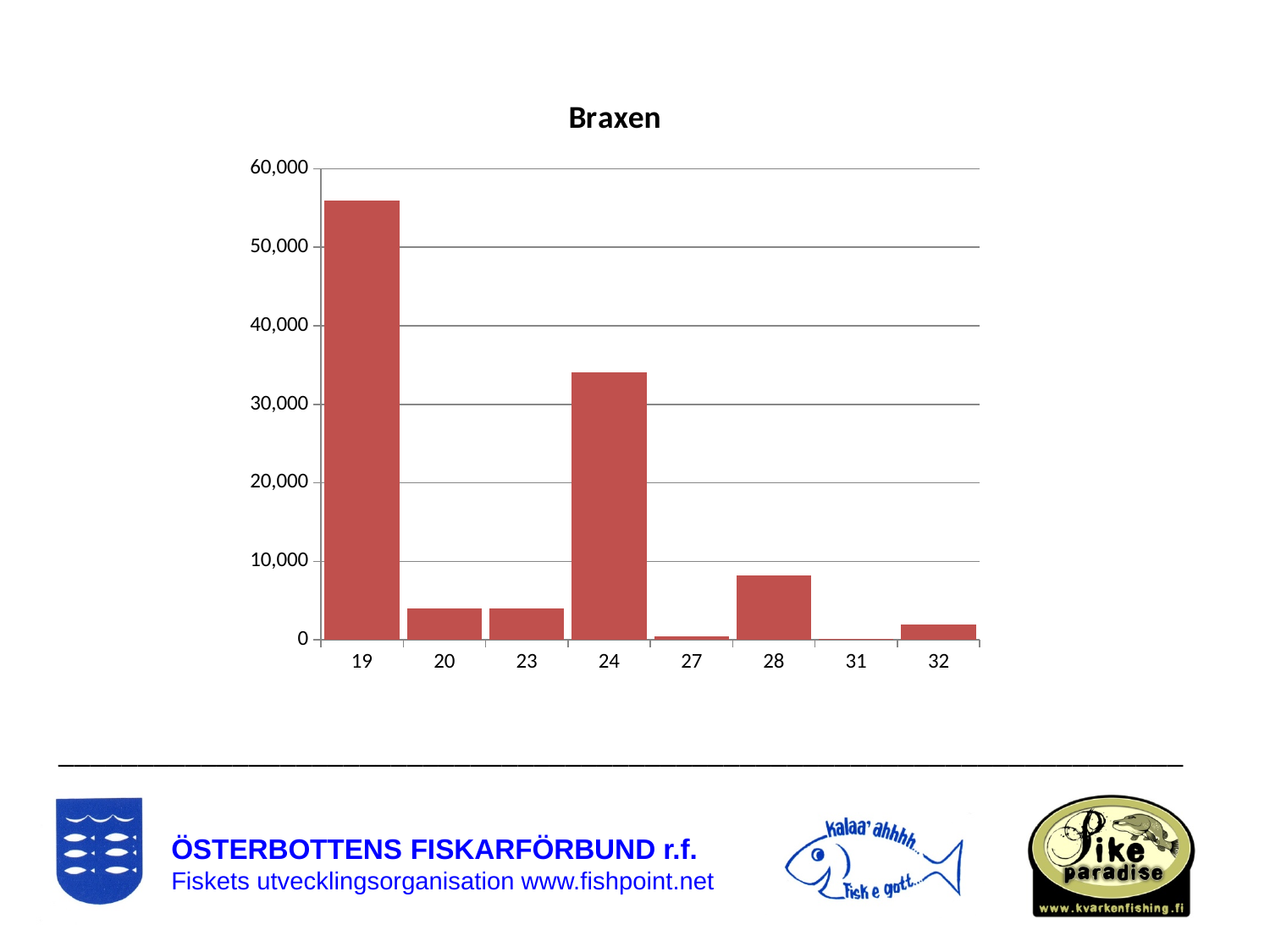
Is the value for category 24 greater or less than 30,000? greater How many categories are shown on the x axis of the chart? 8 What kind of chart is shown on the slide? bar chart Is the value for category 19 greater or less than 50,000? greater What colour are the bars in the chart? red Which has the larger value, category 28 or category 20? 28 What is the title of the chart? Braxen Which category has the lowest value in the chart? 31 Which category has the highest value in the chart? 19 Is the value for category 28 greater or less than 10,000? less Which has the larger value, category 19 or category 24? 19